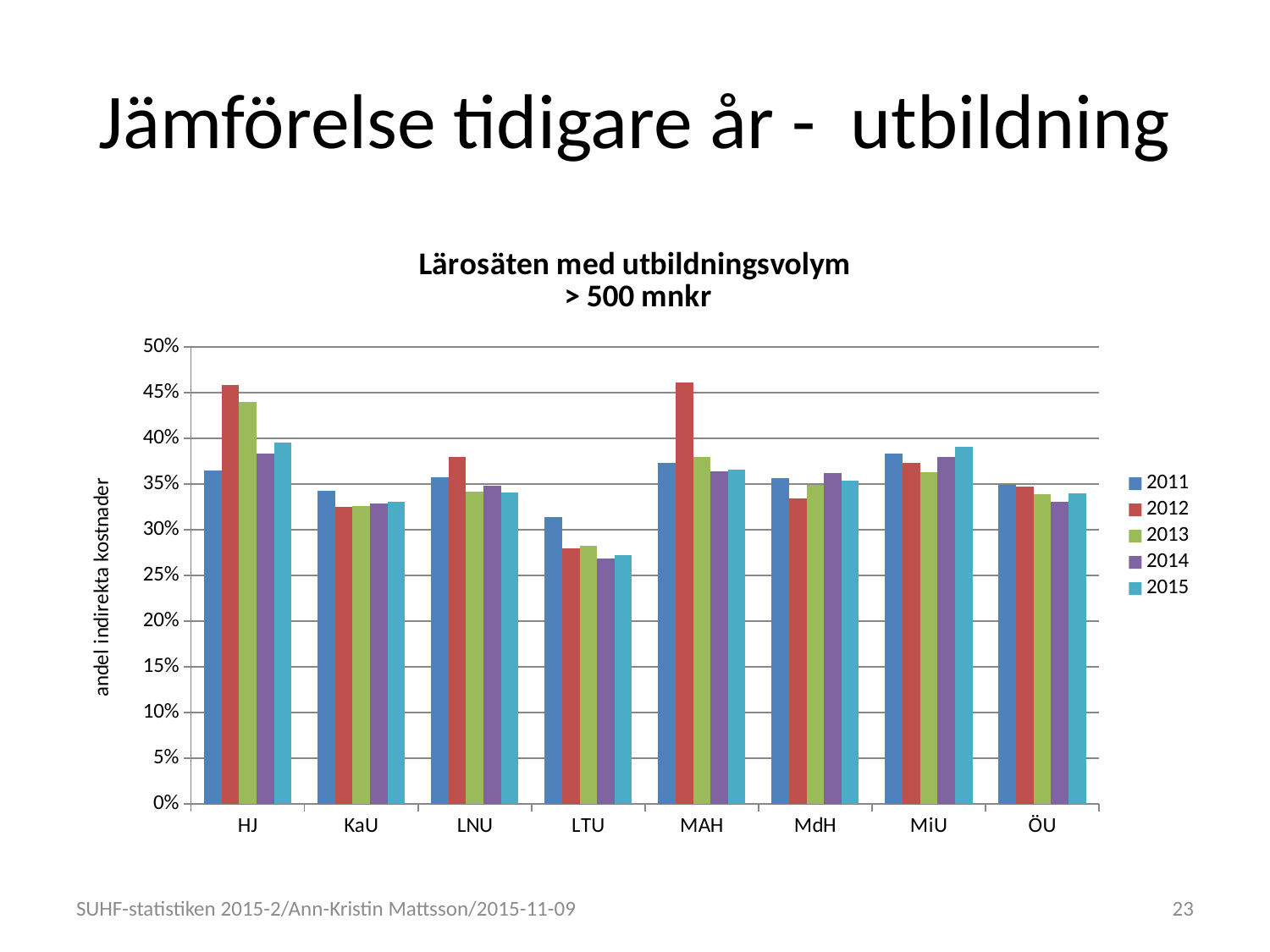
For HJ, does the value rise or fall from 2011 to 2012? rise How many series does the legend list? 5 Which institution has the lowest value for 2015? LTU Is the value for MAH in 2012 greater or less than 40%? greater Which institution has the lowest value for 2011? LTU How many institutions (categories) are shown on the x axis? 8 What is the title of the chart? Lärosäten med utbildningsvolym > 500 mnkr Is the value for HJ in 2012 greater or less than 40%? greater Is the value for KaU in 2011 greater or less than 30%? greater What kind of chart is shown on the slide? bar chart For LTU, which year has the larger value, 2011 or 2015? 2011